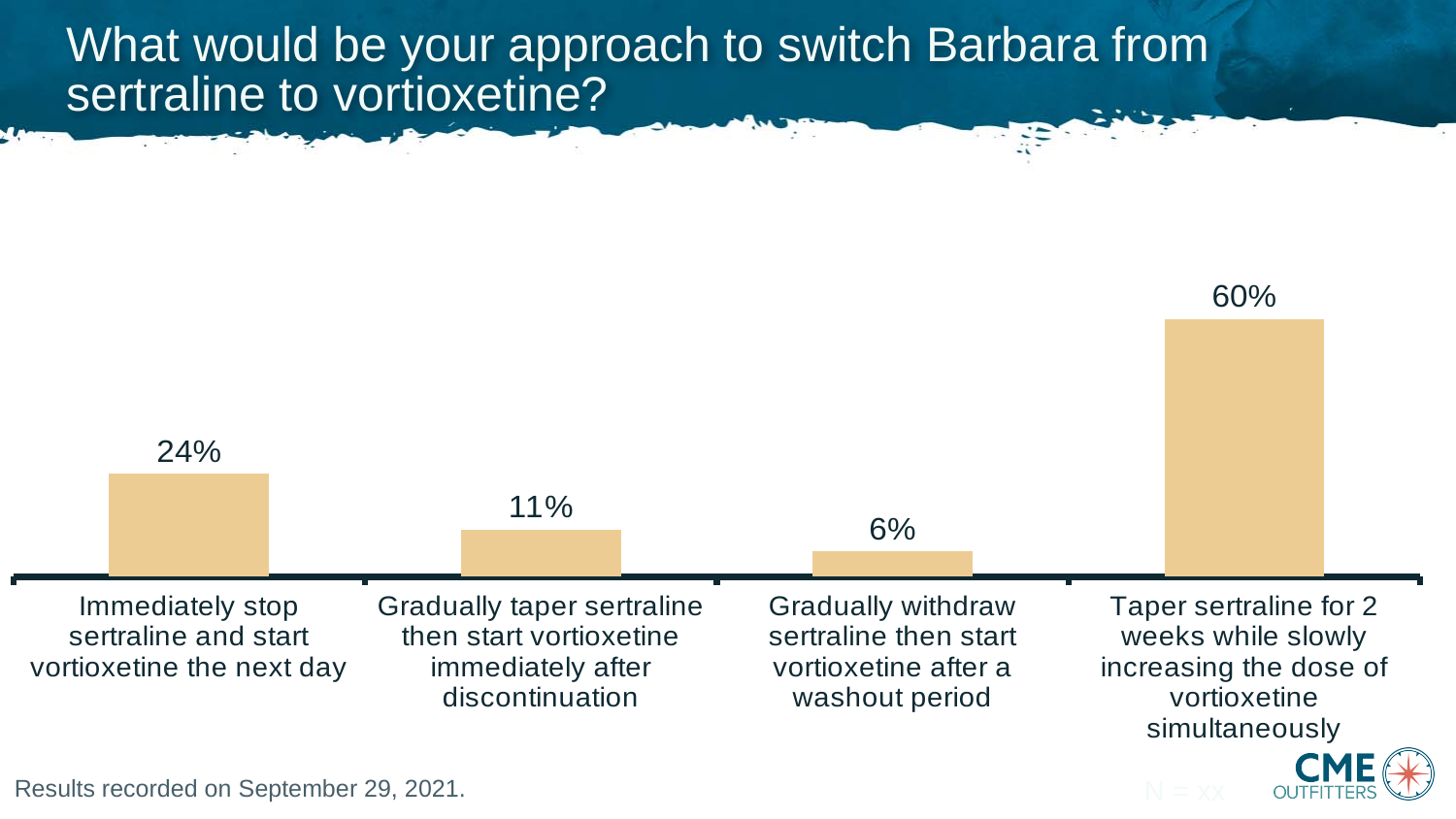
What percentage of respondents chose 'Taper sertraline for 2 weeks while slowly increasing the dose of vortioxetine simultaneously'? 60% What percentage of respondents chose 'Immediately stop sertraline and start vortioxetine the next day'? 24% Which response option received the highest percentage? Taper sertraline for 2 weeks while slowly increasing the dose of vortioxetine simultaneously What type of chart is shown on the slide? Bar chart On what date were the results recorded, according to the slide? September 29, 2021 What is the difference in percentage points between the 'Taper sertraline for 2 weeks' option and the 'Immediately stop sertraline' option? 36 What is the difference in percentage points between the 'Gradually taper sertraline then start vortioxetine immediately' option and the 'Gradually withdraw sertraline ... after a washout period' option? 5 How many response options are shown in the chart? 4 What percentage of respondents chose 'Gradually taper sertraline then start vortioxetine immediately after discontinuation'? 11% Which response option received the lowest percentage? Gradually withdraw sertraline then start vortioxetine after a washout period What percentage of respondents chose 'Gradually withdraw sertraline then start vortioxetine after a washout period'? 6% Which received a larger share: 'Immediately stop sertraline and start vortioxetine the next day' or 'Gradually taper sertraline then start vortioxetine immediately after discontinuation'? Immediately stop sertraline and start vortioxetine the next day